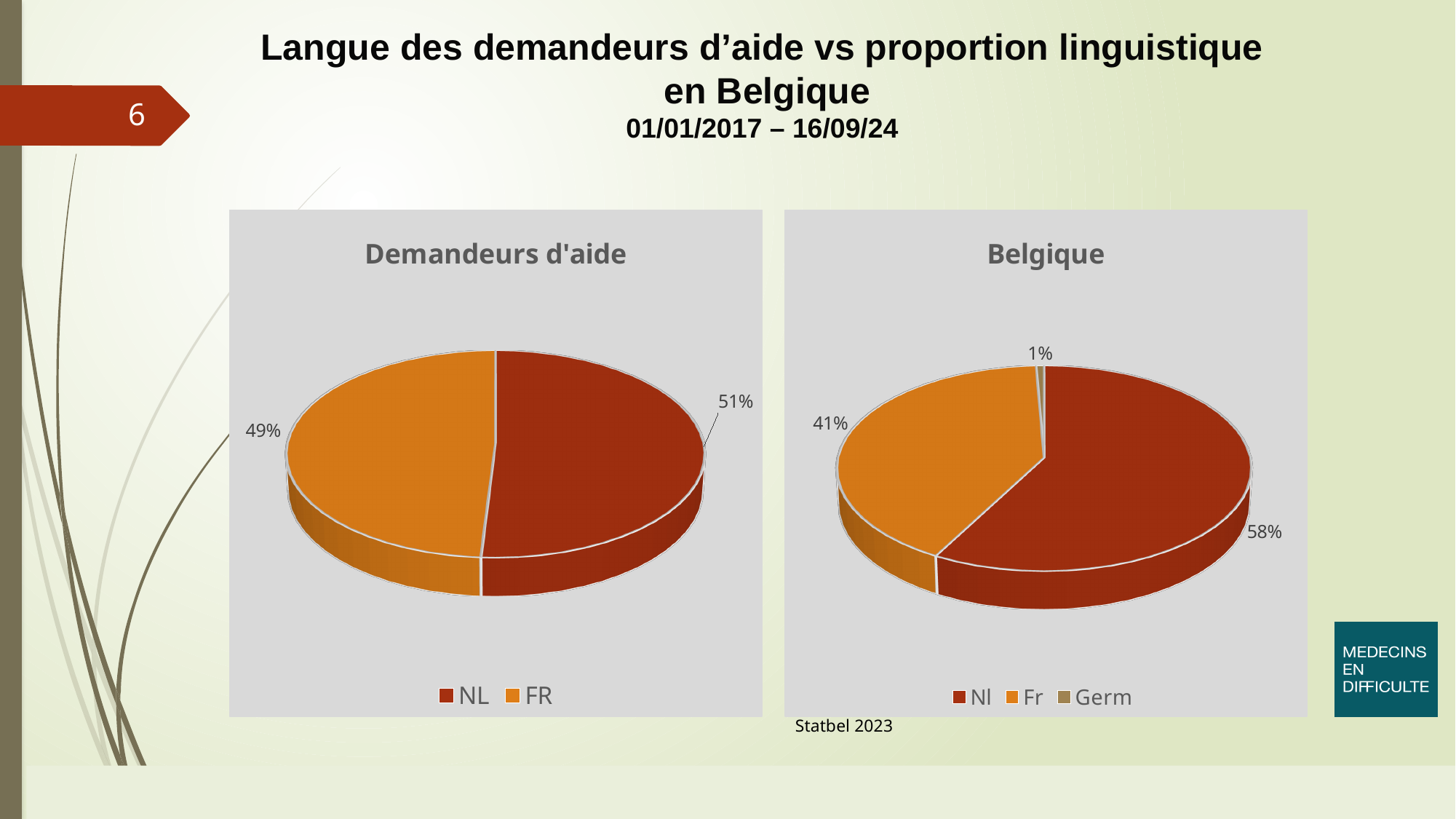
How many categories does the legend of the 'Belgique' chart list? 3 How many categories does the legend of the 'Demandeurs d'aide' chart list? 2 In the 'Belgique' chart, which category has the smallest slice? Germ In the 'Demandeurs d'aide' chart, what share of the pie is NL? 51% In the 'Belgique' chart, which category has the largest slice? Nl In the 'Belgique' chart, what share of the pie is Nl? 58% In the 'Demandeurs d'aide' chart, what share of the pie is FR? 49% In the 'Belgique' chart, what is the difference between the Nl and Fr shares? 17% In the 'Demandeurs d'aide' chart, what is the difference between the NL and FR shares? 2% What kind of chart is the 'Belgique' chart? Pie chart